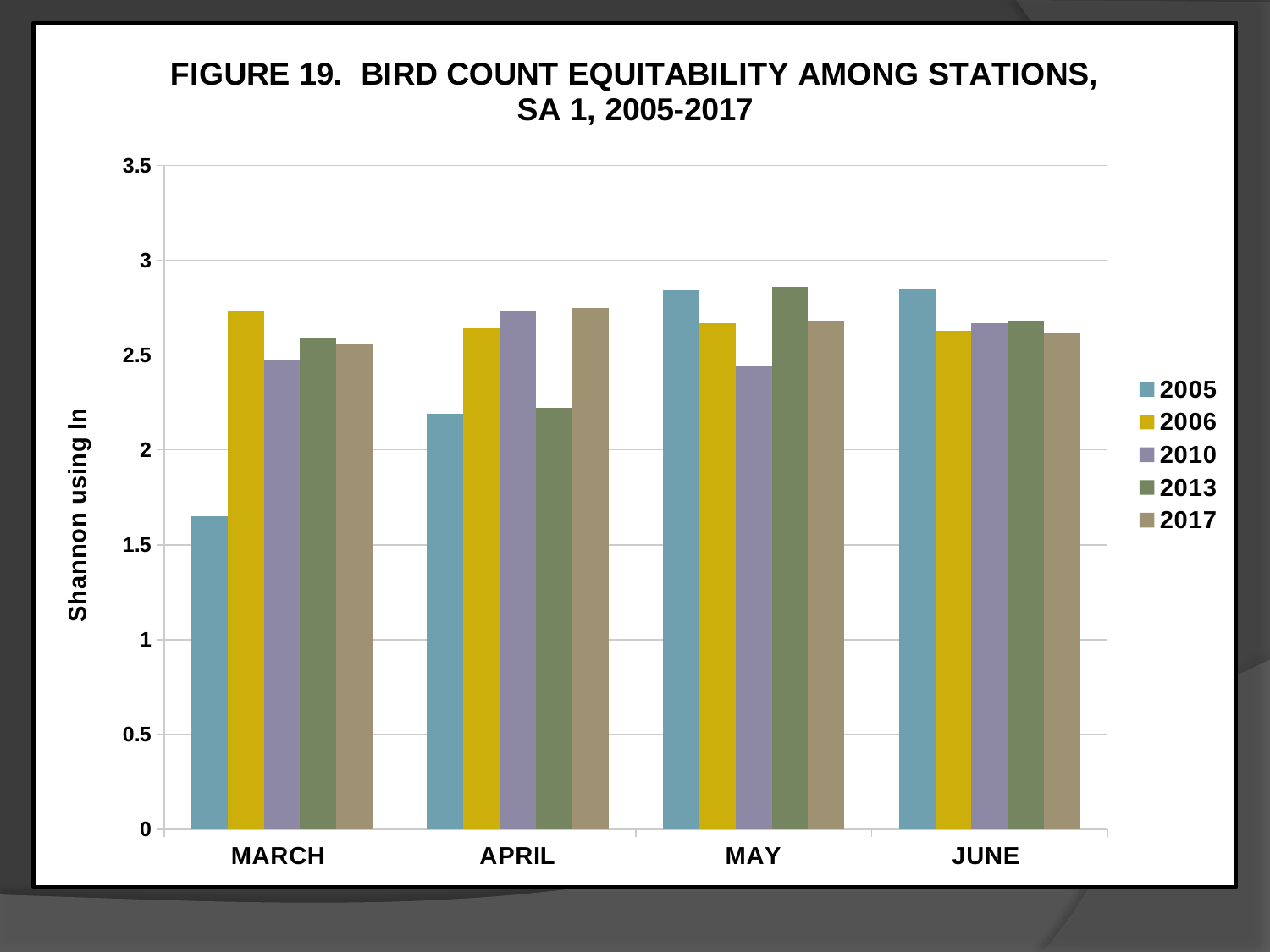
Is the value for 2005 in MARCH greater or less than 2? less What is the label on the vertical axis? Shannon using ln Which is larger: the value for 2013 in APRIL or the value for 2013 in MAY? MAY How many series does the legend list? 5 What kind of chart is shown on the slide? bar chart In APRIL, which is larger: the value for 2005 or the value for 2006? 2006 In MARCH, which year has the lowest value? 2005 In MARCH, which year has the highest value? 2006 What is the title of the chart? FIGURE 19. BIRD COUNT EQUITABILITY AMONG STATIONS, SA 1, 2005-2017 Is the value for 2005 in MAY greater or less than 2.5? greater How many month categories are shown on the x axis? 4 Do the values for the 2005 series rise or fall from MARCH to JUNE? rise